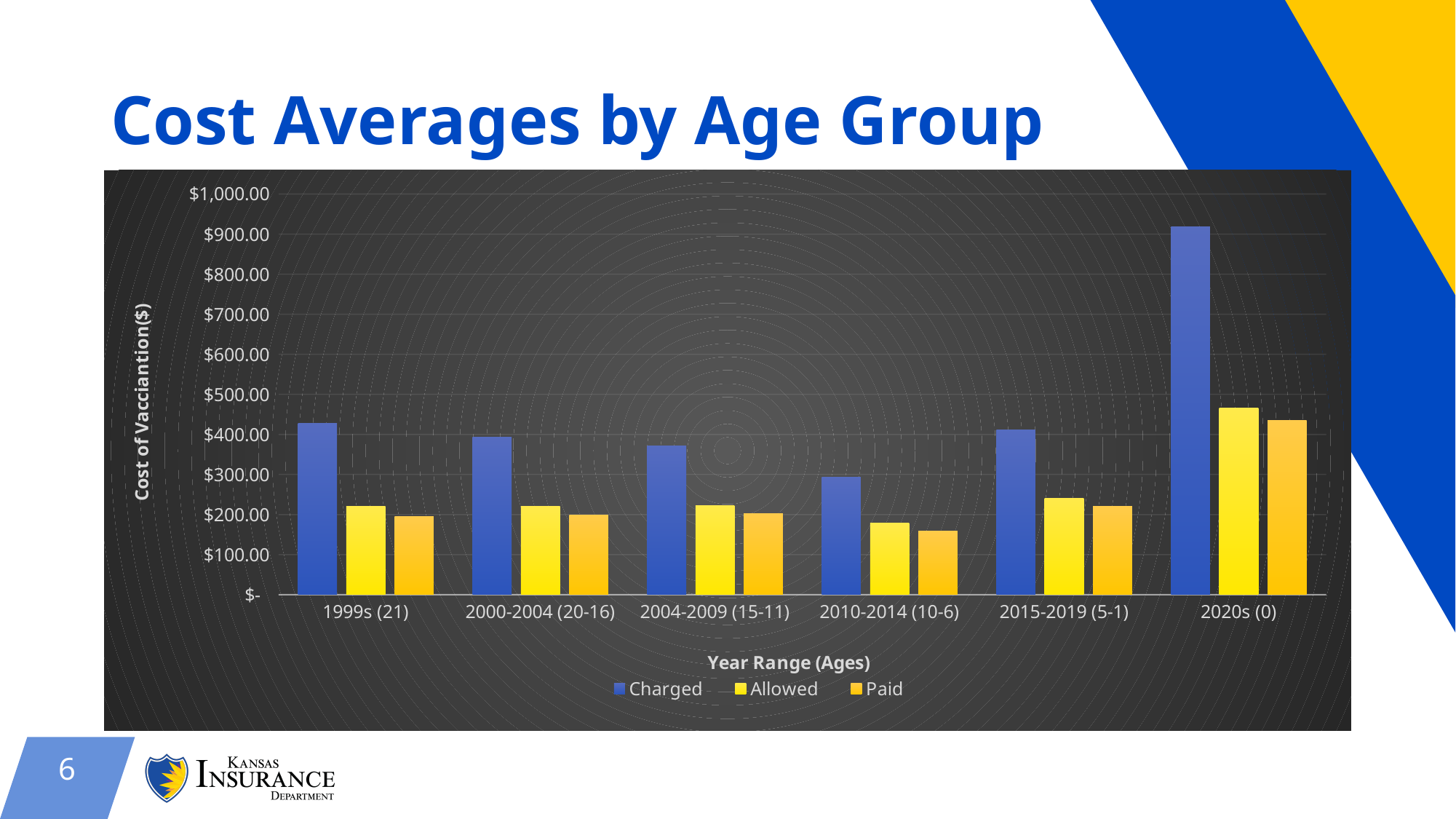
Which year range has the lowest Charged value? 2010-2014 (10-6) Is the Charged value for 2020s (0) greater or less than $800.00? greater Which year range has the highest Charged value? 2020s (0) What is the title of the x axis? Year Range (Ages) What kind of chart is shown on the slide? bar chart Is the Paid value for 2010-2014 (10-6) greater or less than $200.00? less How many series does the legend list? 3 Which year range has the highest Allowed value? 2020s (0) Is the Charged value for 1999s (21) greater or less than $400.00? greater Which year range has the lowest Paid value? 2010-2014 (10-6) For 2020s (0), which is larger, the Allowed value or the Paid value? Allowed How many year-range categories are shown on the x axis? 6